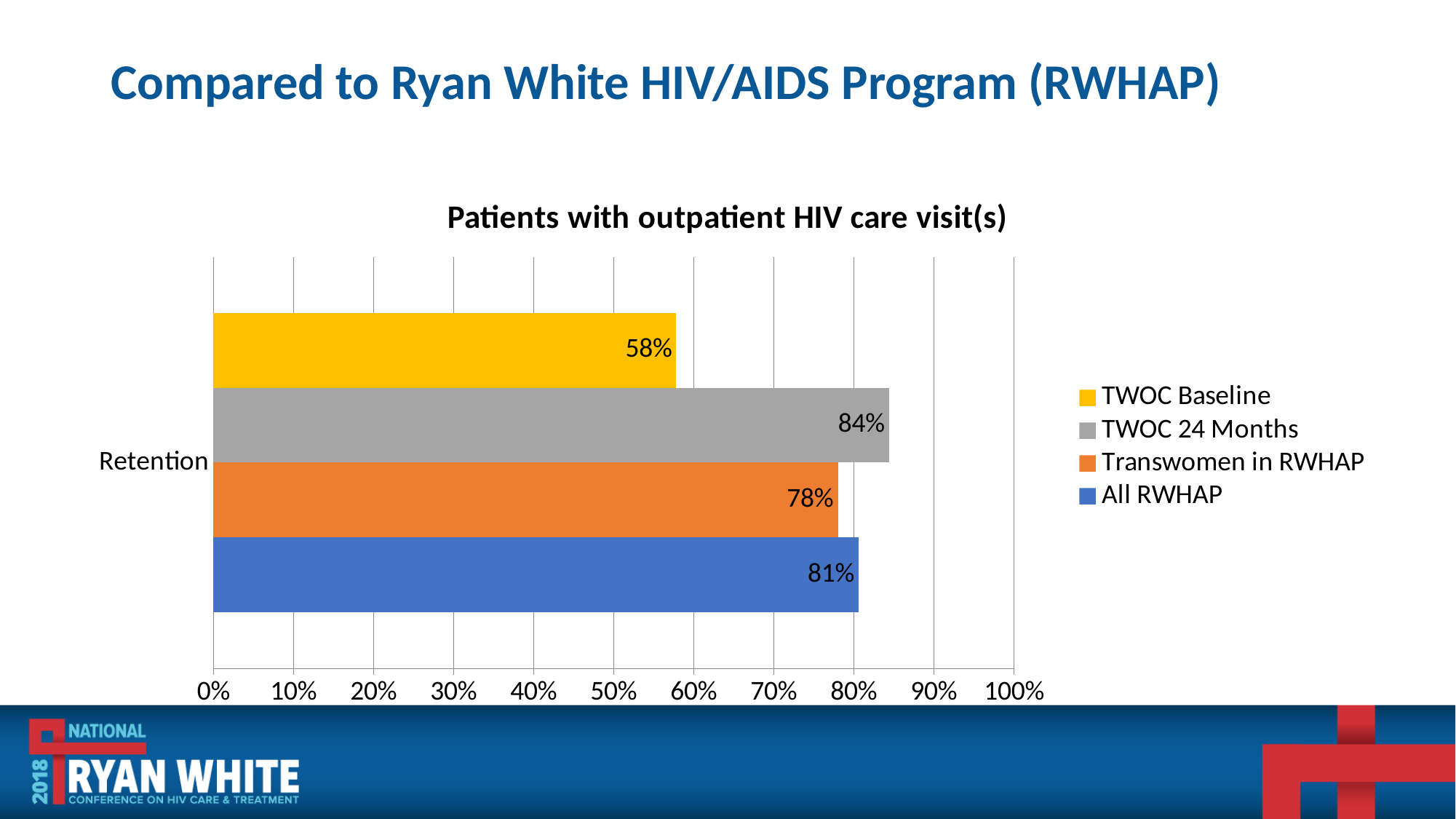
What kind of chart is shown? bar chart What is the value for TWOC 24 Months? 84% What is the difference between TWOC 24 Months and TWOC Baseline? 26% What is the value for TWOC Baseline? 58% Is the value for TWOC Baseline greater or less than 60%? less Which series has the highest value? TWOC 24 Months What is the title of the chart? Patients with outpatient HIV care visit(s) How many series does the legend list? 4 Which is larger, All RWHAP or Transwomen in RWHAP? All RWHAP Which series has the lowest value? TWOC Baseline What is the value for Transwomen in RWHAP? 78% What is the value for All RWHAP? 81%